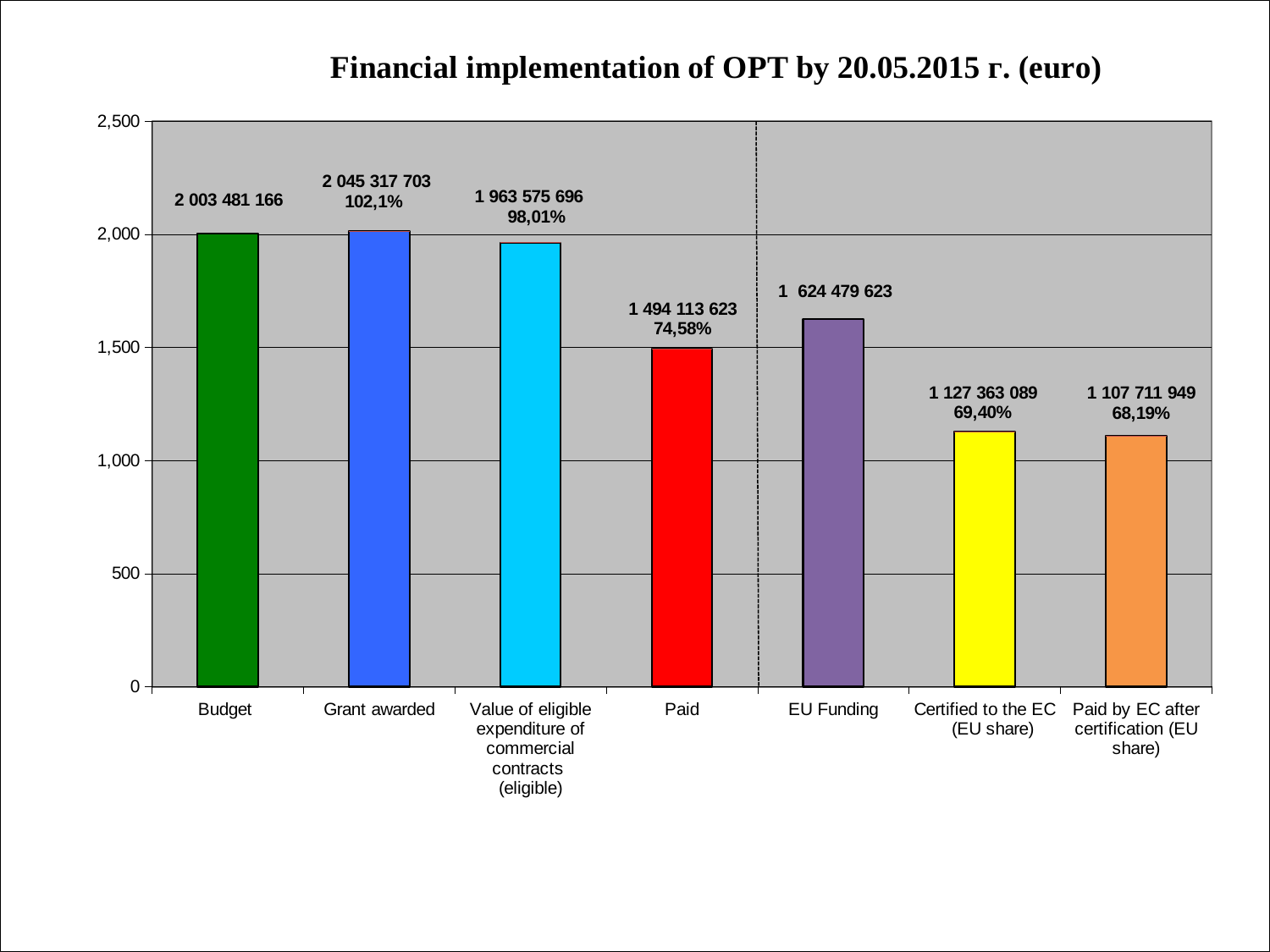
What percentage is shown for Paid by EC after certification (EU share)? 68,19% What is the difference between the Budget value and the Paid value? 509 367 543 What is the value for Certified to the EC (EU share)? 1 127 363 089 Is the value for EU Funding greater or less than 1,500? greater What is the value for Grant awarded? 2 045 317 703 What kind of chart is shown on the slide? bar chart Which category has the highest value? Grant awarded How many categories are shown on the x axis? 7 Which category has the lowest value? Paid by EC after certification (EU share) What percentage is shown above the Paid bar? 74,58% What is the value for Budget? 2 003 481 166 Which is larger, the value for EU Funding or the value for Paid? EU Funding